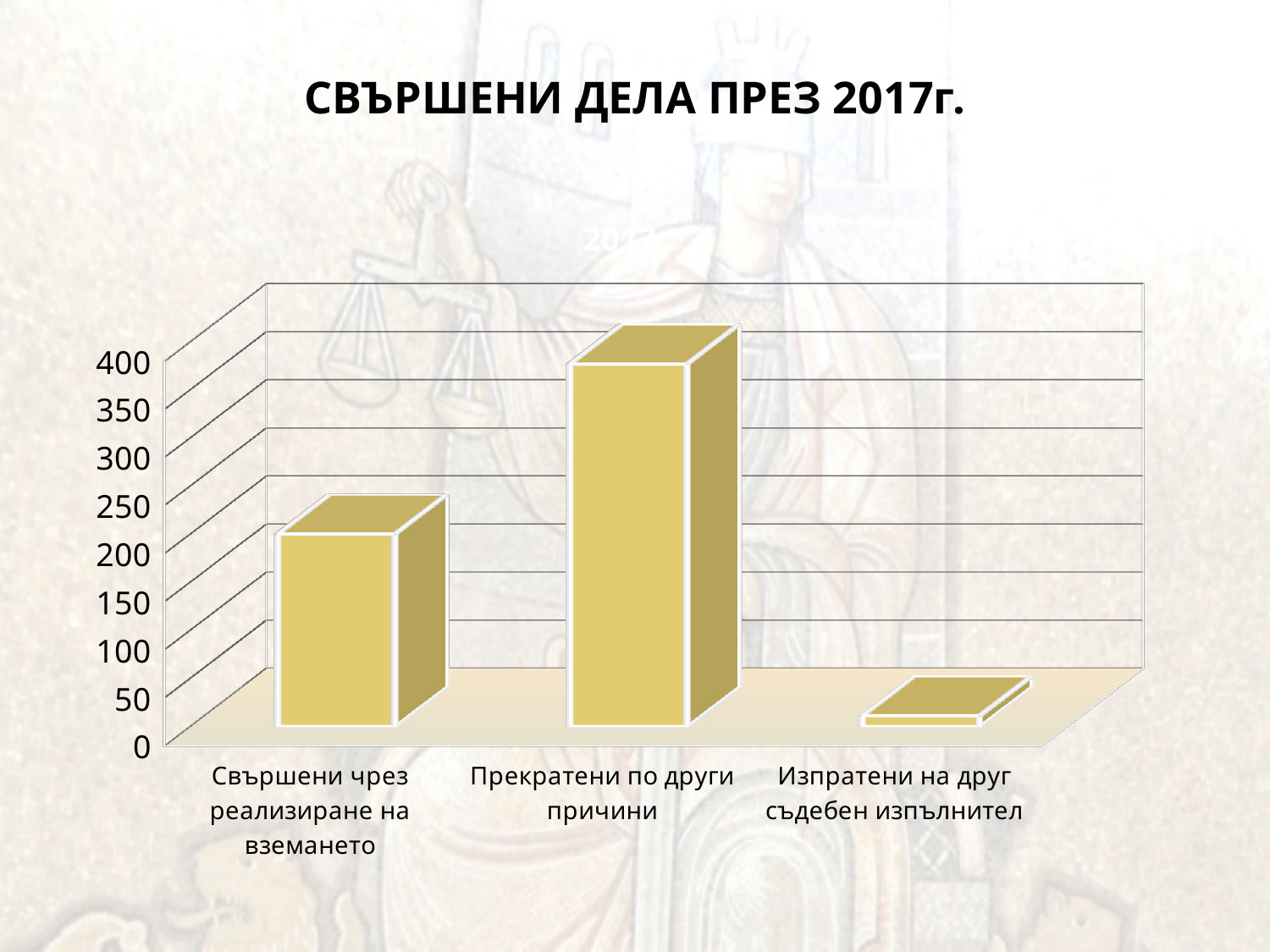
How many categories are shown on the x axis of the chart? 3 Which category has the highest bar? Прекратени по други причини Is the value for "Изпратени на друг съдебен изпълнител" greater or less than 50? less Is the value for "Свършени чрез реализиране на вземането" greater or less than 250? less Is the value for "Свършени чрез реализиране на вземането" greater or less than 150? greater Which is larger: the value for "Свършени чрез реализиране на вземането" or the value for "Изпратени на друг съдебен изпълнител"? Свършени чрез реализиране на вземането Which category has the lowest bar? Изпратени на друг съдебен изпълнител Which is larger: the value for "Прекратени по други причини" or the value for "Свършени чрез реализиране на вземането"? Прекратени по други причини What kind of chart is shown on the slide? bar chart What is the title of the slide? СВЪРШЕНИ ДЕЛА ПРЕЗ 2017г. What is the highest tick value shown on the vertical axis? 400